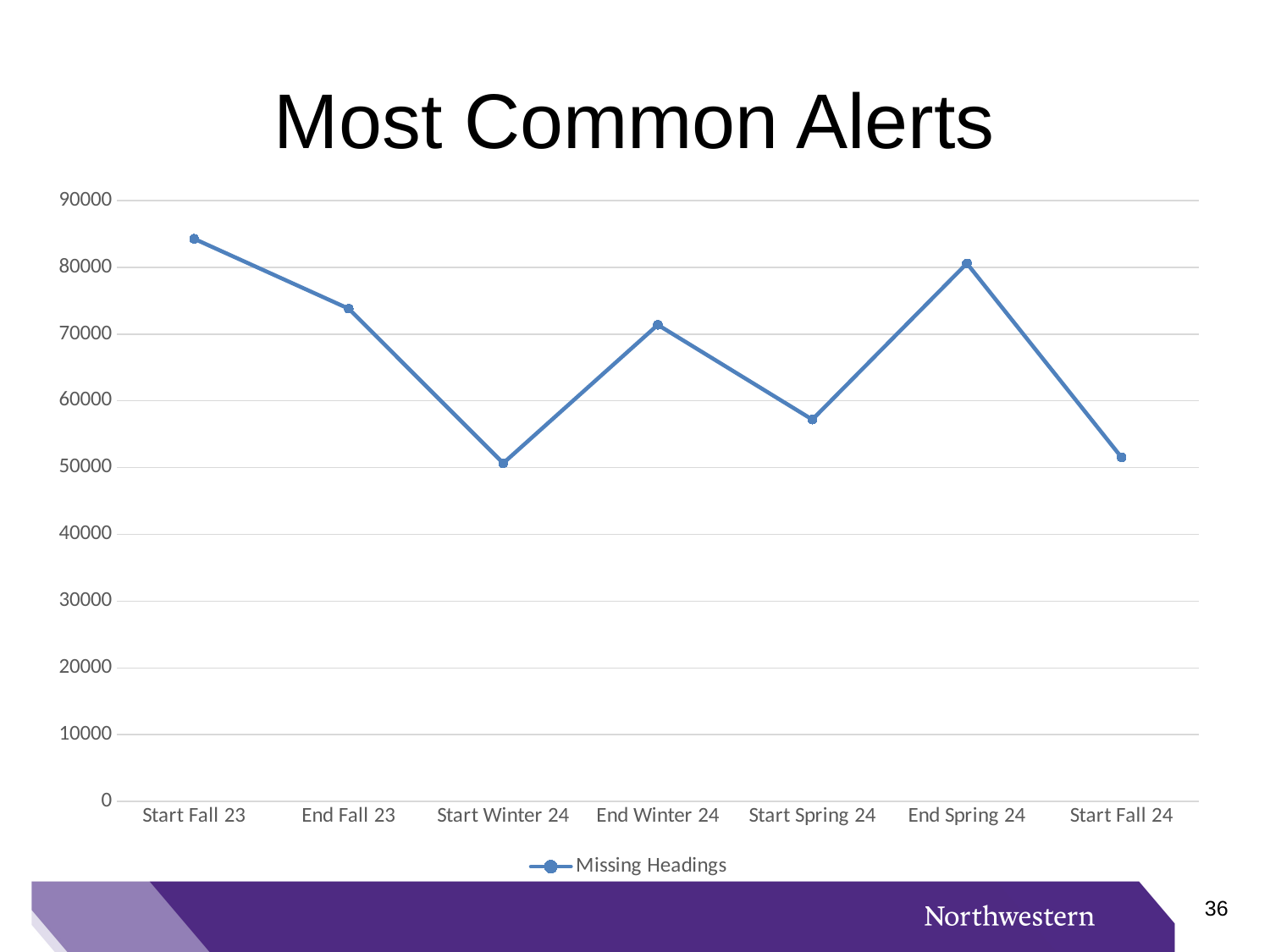
How many series does the legend list? 1 Which point has the highest value for Missing Headings? Start Fall 23 Is the value for Start Fall 24 greater or less than 60000? less Is the value for Start Fall 23 greater or less than 80000? greater What is the title of the chart? Most Common Alerts What is the name of the series shown in the legend? Missing Headings How many points are plotted along the x axis? 7 Do the values rise or fall from Start Fall 23 to Start Winter 24? fall Is the value for Start Winter 24 greater or less than 60000? less What kind of chart is shown on the slide? line chart Which is larger, the value for End Winter 24 or the value for Start Spring 24? End Winter 24